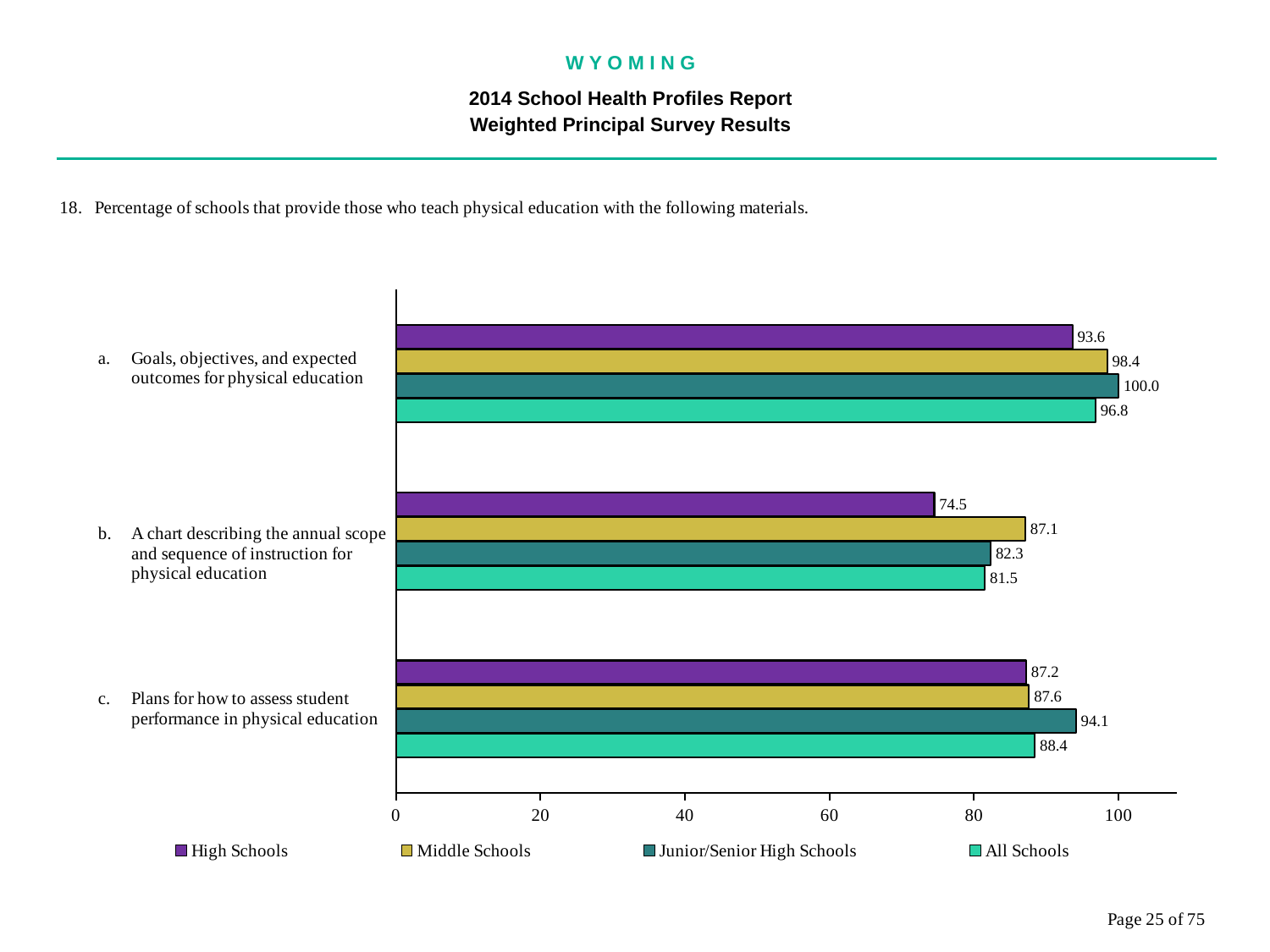
How many items (categories) are shown on the chart? 3 What kind of chart is shown on the slide? bar chart Which series is shown in purple in the legend? High Schools What is the value for Junior/Senior High Schools for item b, a chart describing the annual scope and sequence of instruction for physical education? 82.3 What is the value for All Schools for item c, plans for how to assess student performance in physical education? 88.4 What is the value for High Schools for item a, goals, objectives, and expected outcomes for physical education? 93.6 Is the High Schools value for item b, a chart describing the annual scope and sequence of instruction, greater or less than 80? less For item c, plans for how to assess student performance, which is larger: the Junior/Senior High Schools value or the Middle Schools value? Junior/Senior High Schools Which school type has the lowest value for item b, a chart describing the annual scope and sequence of instruction for physical education? High Schools How many series does the legend list? 4 What is the difference between the Middle Schools and High Schools values for item b, a chart describing the annual scope and sequence of instruction? 12.6 Which school type has the highest value for item a, goals, objectives, and expected outcomes for physical education? Junior/Senior High Schools